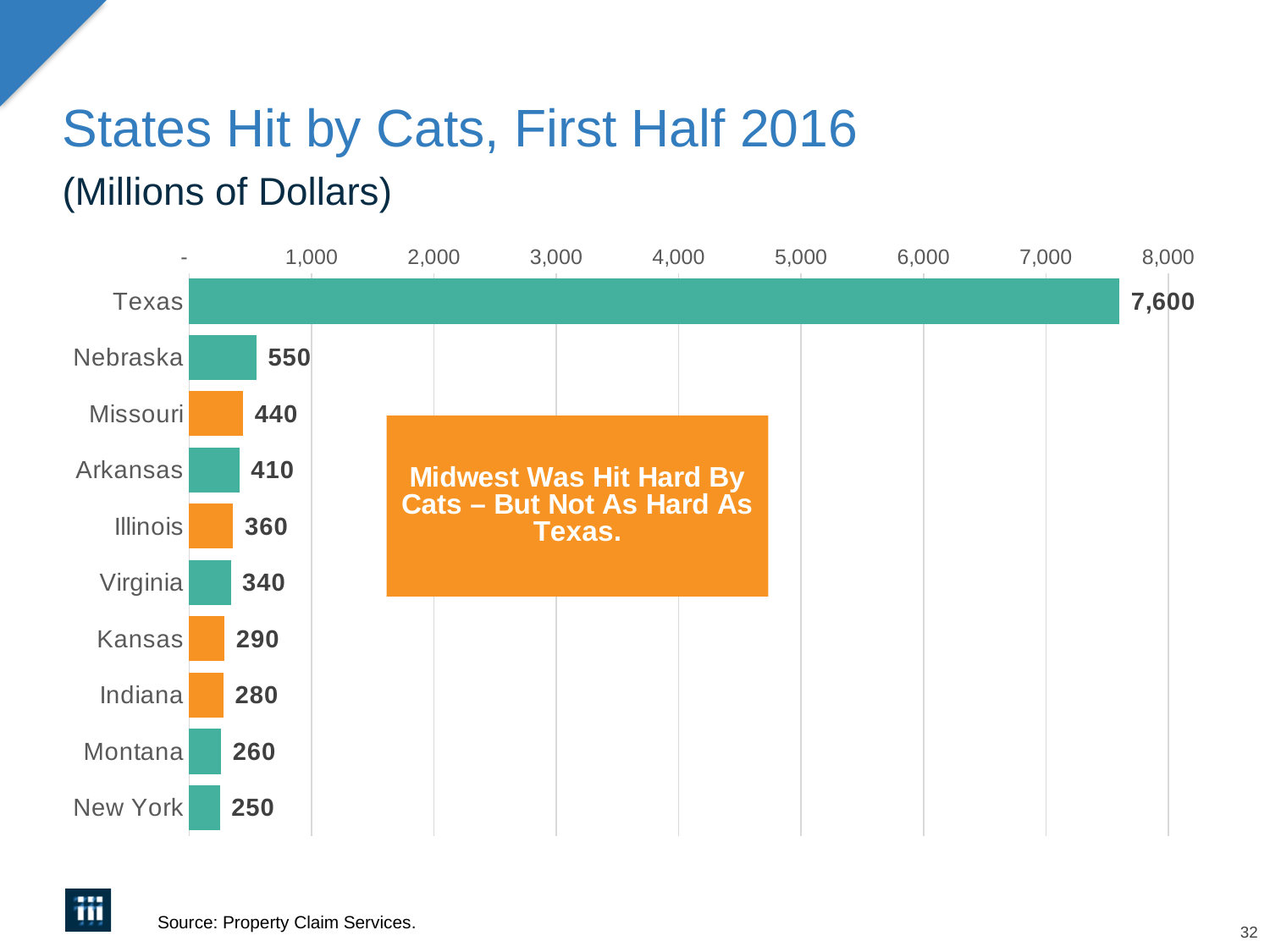
What is the difference between the values for Missouri and Arkansas? 30 What is the difference between the values for Texas and Nebraska? 7,050 What is the title of the chart? States Hit by Cats, First Half 2016 Which state has the highest value? Texas What is the value for Illinois? 360 How many states are shown in the chart? 10 Is the value for Texas greater or less than 7,000? greater What kind of chart is shown on the slide? bar chart What is the value for Nebraska? 550 Which is larger, the value for Kansas or the value for Montana? Kansas Which state has the lowest value? New York What is the value for Texas? 7,600